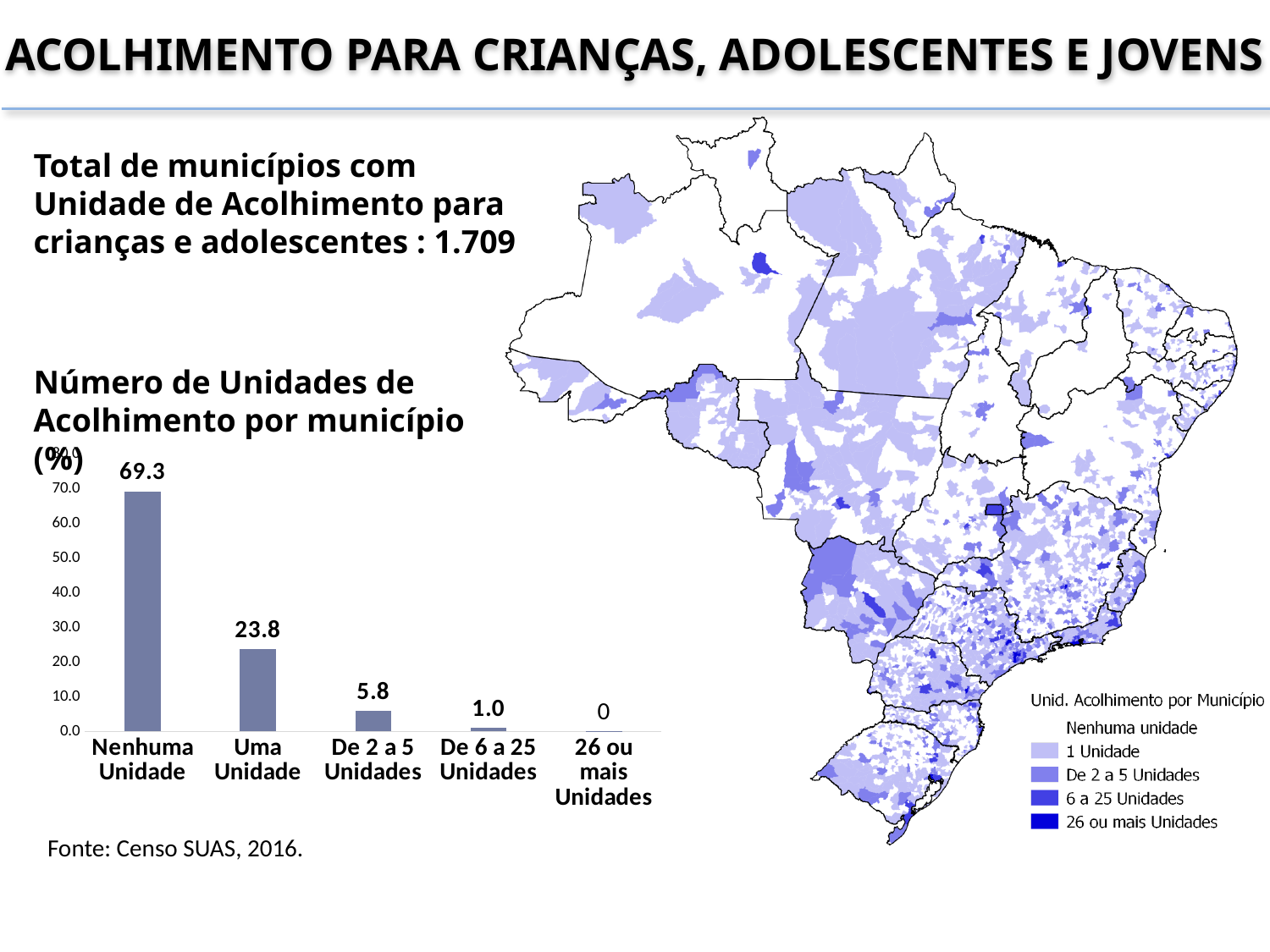
What is the value for "26 ou mais Unidades" in the bar chart? 0 What kind of chart is shown on the left of the slide? Bar chart What is the difference between the values for "Nenhuma Unidade" and "Uma Unidade" in the bar chart? 45.5 How many categories are shown in the bar chart? 5 What is the value for "Nenhuma Unidade" in the bar chart? 69.3 What is the value for "De 6 a 25 Unidades" in the bar chart? 1.0 Which category has the lowest value in the bar chart? 26 ou mais Unidades What is the value for "De 2 a 5 Unidades" in the bar chart? 5.8 What is the value for "Uma Unidade" in the bar chart? 23.8 Do the values in the bar chart rise or fall from left to right along the x axis? Fall Which category has the highest value in the bar chart? Nenhuma Unidade Which is larger in the bar chart, the value for "Uma Unidade" or "De 2 a 5 Unidades"? Uma Unidade